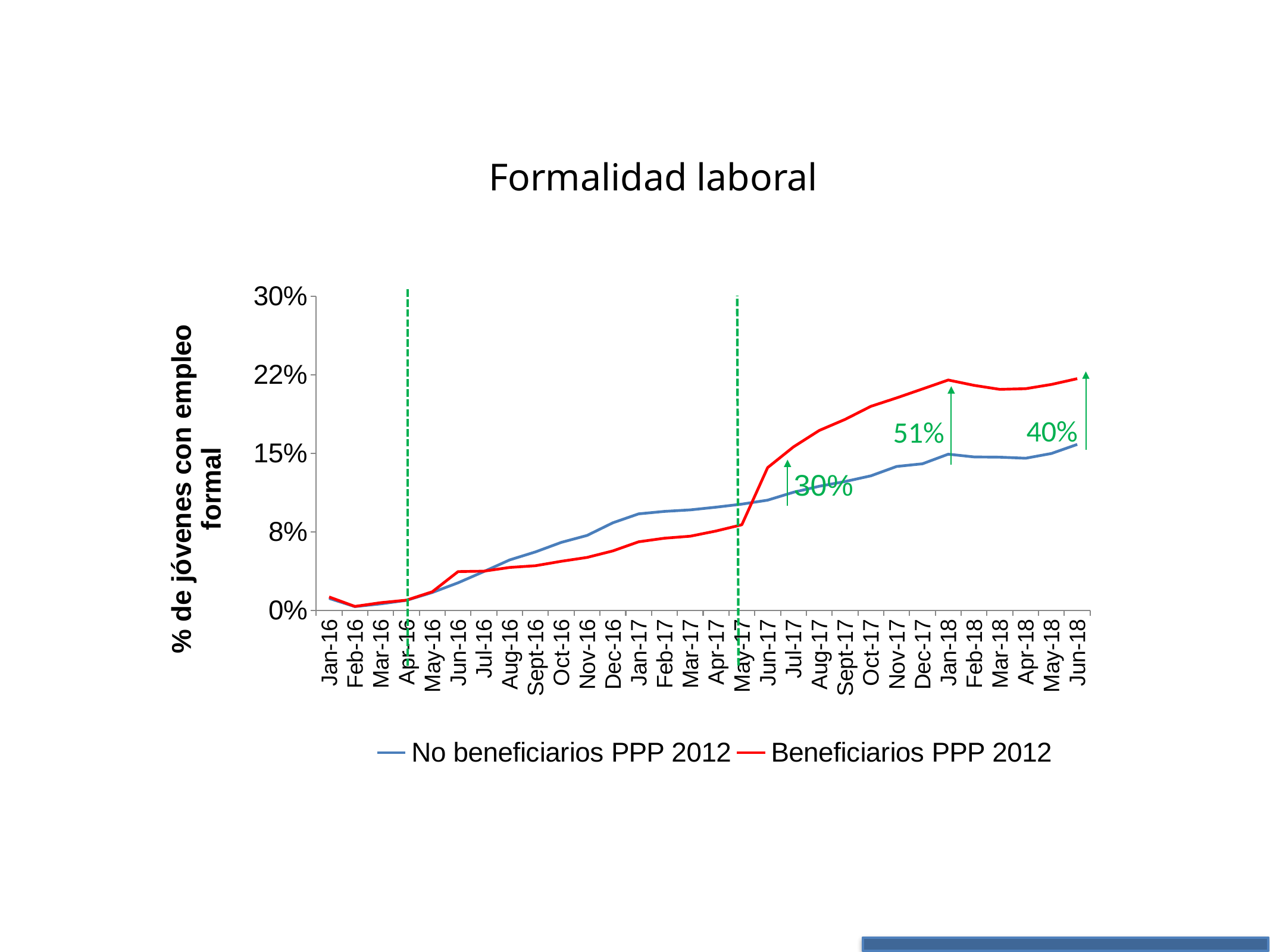
How many months are shown along the x axis? 30 What kind of chart is shown on the slide? line chart What is the title of the chart? Formalidad laboral At Jun-18, which series has the higher value, No beneficiarios PPP 2012 or Beneficiarios PPP 2012? Beneficiarios PPP 2012 Is the value for No beneficiarios PPP 2012 at Jan-17 greater or less than 8%? greater What percentage label is printed next to the green arrow at Jan-18? 51% Is the value for Beneficiarios PPP 2012 at Jan-18 greater or less than 15%? greater Is the value for Beneficiarios PPP 2012 at Jan-17 greater or less than 8%? less How many series does the legend list? 2 At Jan-17, which series has the higher value, No beneficiarios PPP 2012 or Beneficiarios PPP 2012? No beneficiarios PPP 2012 Does the Beneficiarios PPP 2012 line generally rise or fall from Jan-16 to Jun-18? rise